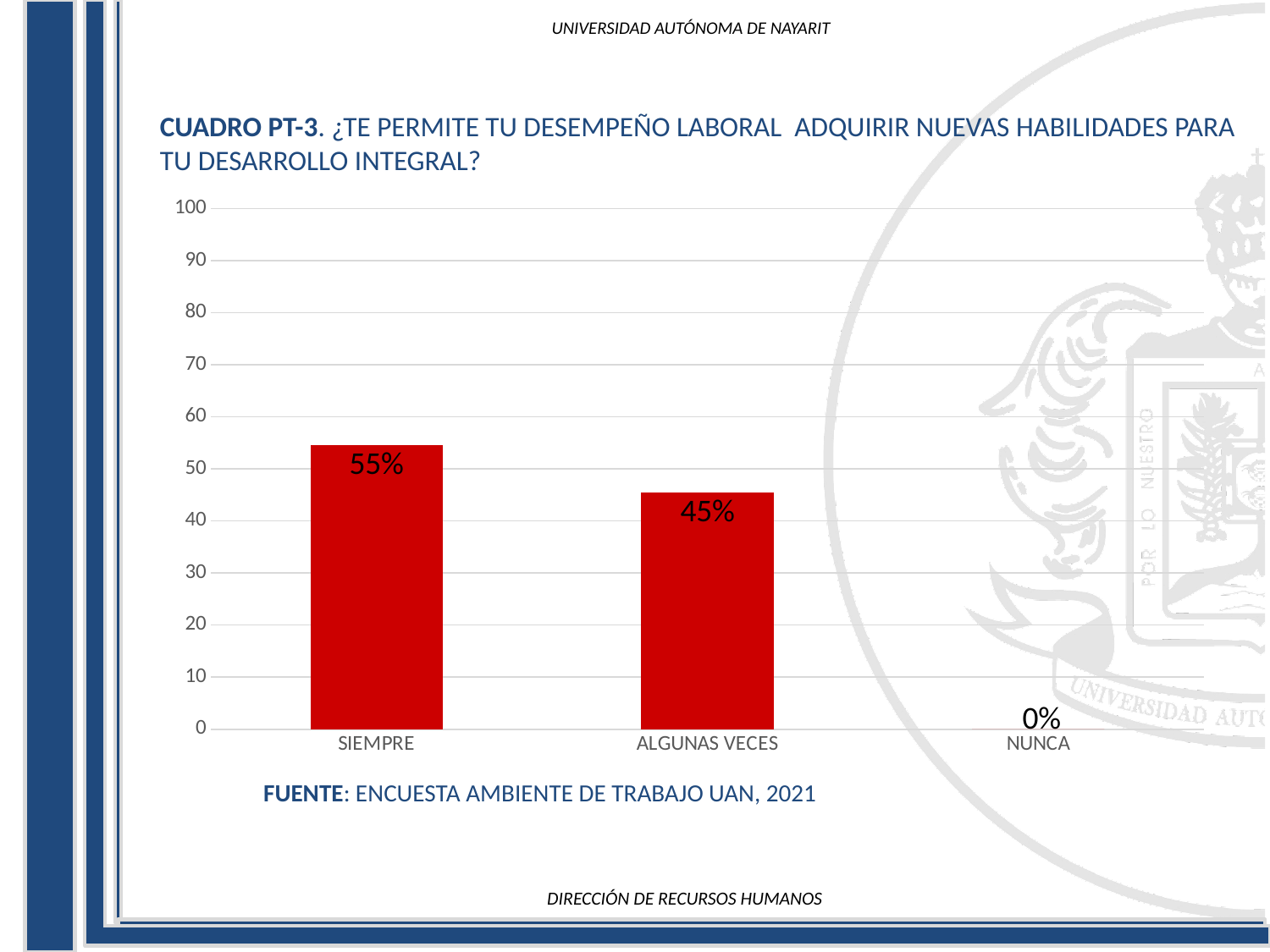
What kind of chart is shown on the slide? bar chart Is the value for ALGUNAS VECES greater or less than 50? less Which is larger, the value for SIEMPRE or the value for ALGUNAS VECES? SIEMPRE What is the value for SIEMPRE? 55% What is the value for NUNCA? 0% What is the difference between the values for SIEMPRE and ALGUNAS VECES? 10% Which category has the lowest value? NUNCA Which category has the highest value? SIEMPRE What is the value for ALGUNAS VECES? 45% What source is cited below the chart? ENCUESTA AMBIENTE DE TRABAJO UAN, 2021 How many categories are shown on the x axis? 3 Do the values rise or fall from left to right along the x axis? fall